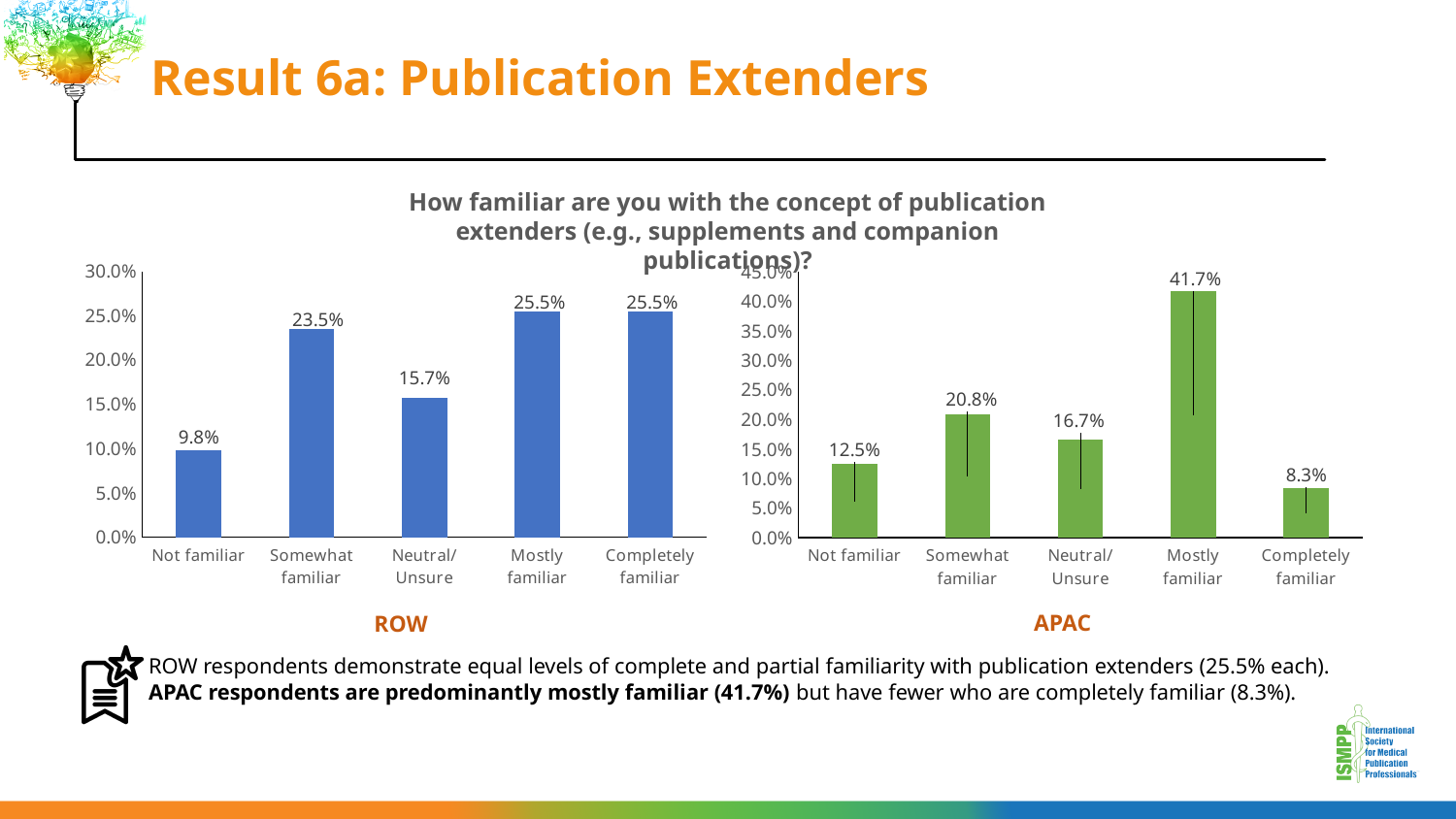
How many categories are shown in the ROW chart? 5 In the ROW chart, which category has the lowest value? Not familiar In the APAC chart, what is the value for Not familiar? 12.5% Which is larger: Completely familiar in the ROW chart or Completely familiar in the APAC chart? ROW In the APAC chart, which category has the highest value? Mostly familiar In the ROW chart, what is the value for Somewhat familiar? 23.5% In the ROW chart, what is the value for Neutral/Unsure? 15.7% In the ROW chart, what is the difference between Somewhat familiar and Not familiar? 13.7% In the APAC chart, which category has the lowest value? Completely familiar In the APAC chart, what is the difference between Mostly familiar and Completely familiar? 33.4% What type of chart is the APAC chart? Bar chart In the APAC chart, what is the value for Mostly familiar? 41.7%